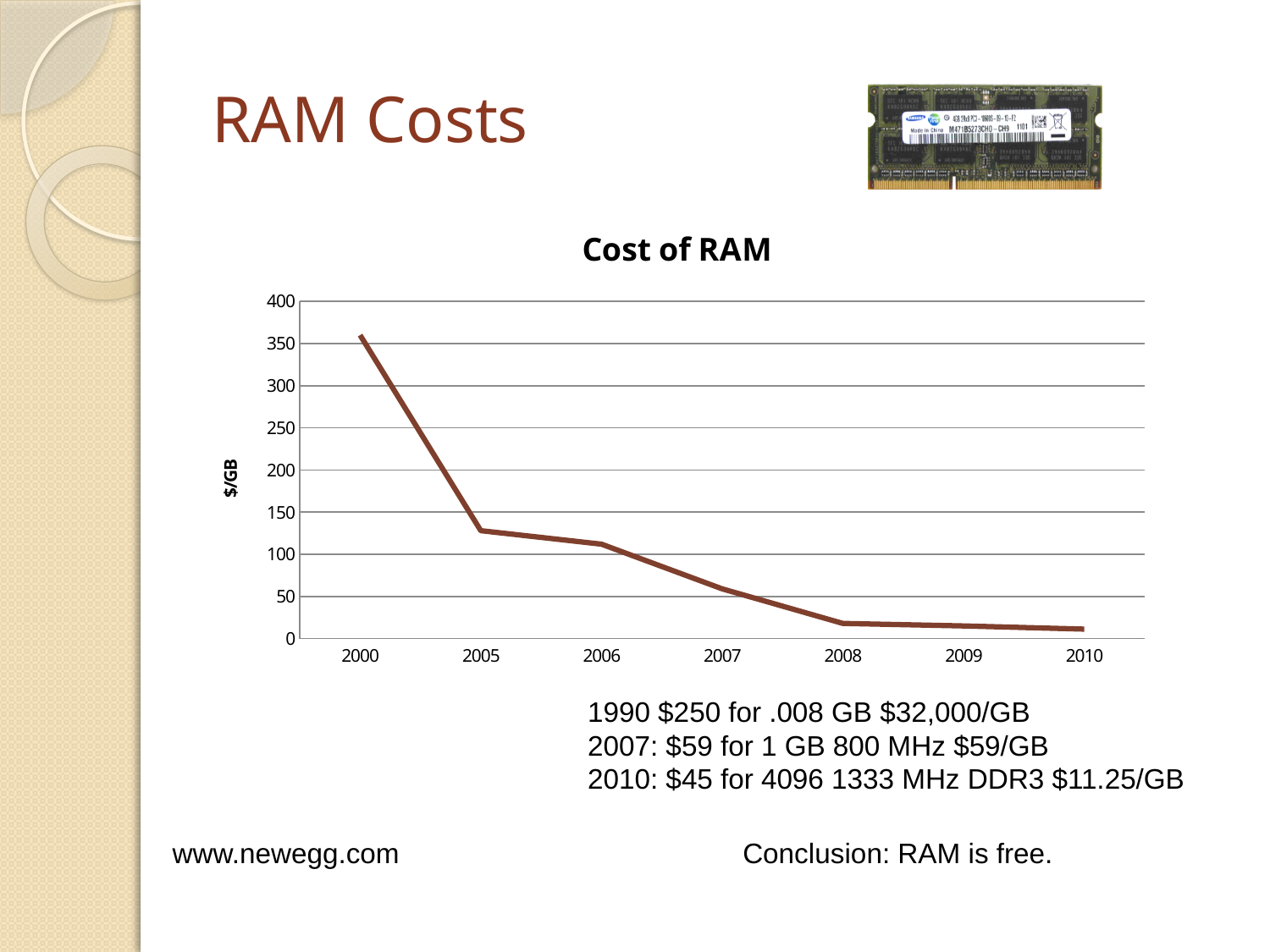
In the "Cost of RAM" chart, which year has the larger value, 2000 or 2005? 2000 Is the value for 2000 in the "Cost of RAM" chart greater or less than 300? greater Is the value for 2005 in the "Cost of RAM" chart greater or less than 150? less What is the label on the y axis of the "Cost of RAM" chart? $/GB Is the value for 2008 in the "Cost of RAM" chart greater or less than 50? less What is the title of the chart on the slide? Cost of RAM How many years are plotted on the x axis of the "Cost of RAM" chart? 7 Which year has the highest cost per GB in the "Cost of RAM" chart? 2000 Does the cost of RAM rise or fall from 2000 to 2010 in the chart? fall What kind of chart is the "Cost of RAM" chart? line chart